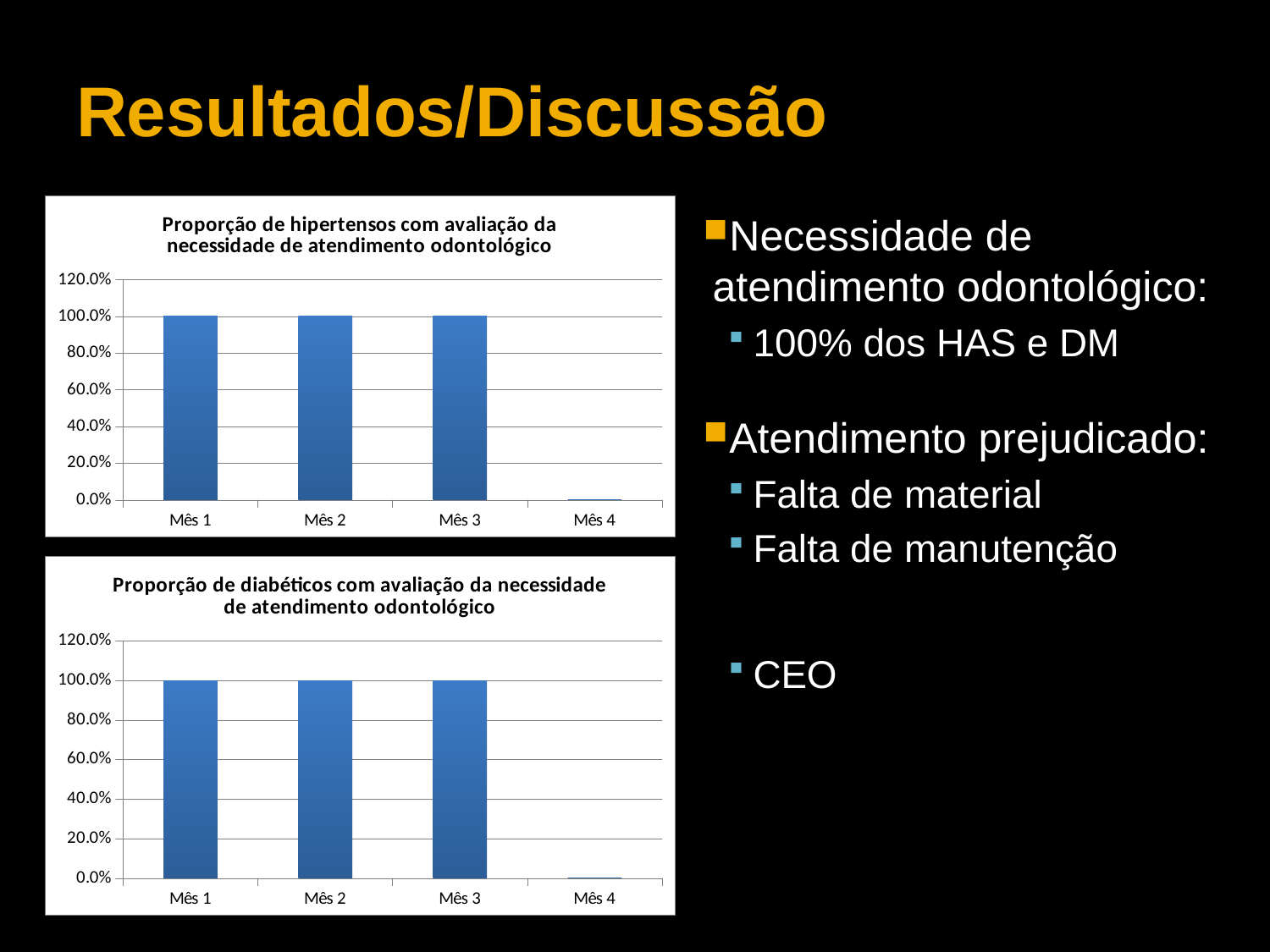
In the top chart (Proporção de hipertensos), what is the value for Mês 3? 100.0% What kind of chart is the top chart (Proporção de hipertensos)? Bar chart In the top chart (Proporção de hipertensos), how many months are shown on the x axis? 4 In the bottom chart (Proporção de diabéticos com avaliação da necessidade de atendimento odontológico), what is the value for Mês 2? 100.0% What is the title of the bottom chart? Proporção de diabéticos com avaliação da necessidade de atendimento odontológico In the bottom chart (Proporção de diabéticos), which month has the lowest value? Mês 4 In the bottom chart (Proporção de diabéticos), which is larger, the value for Mês 1 or the value for Mês 4? Mês 1 In the top chart (Proporção de hipertensos), is the value for Mês 4 greater or less than 20.0%? less In the top chart (Proporção de hipertensos), which month has the lowest value? Mês 4 In the bottom chart (Proporção de diabéticos), what is the highest value shown on the y axis? 120.0% In the top chart (Proporção de hipertensos com avaliação da necessidade de atendimento odontológico), what is the value for Mês 1? 100.0% In the bottom chart (Proporção de diabéticos), is the value for Mês 4 greater or less than 20.0%? less